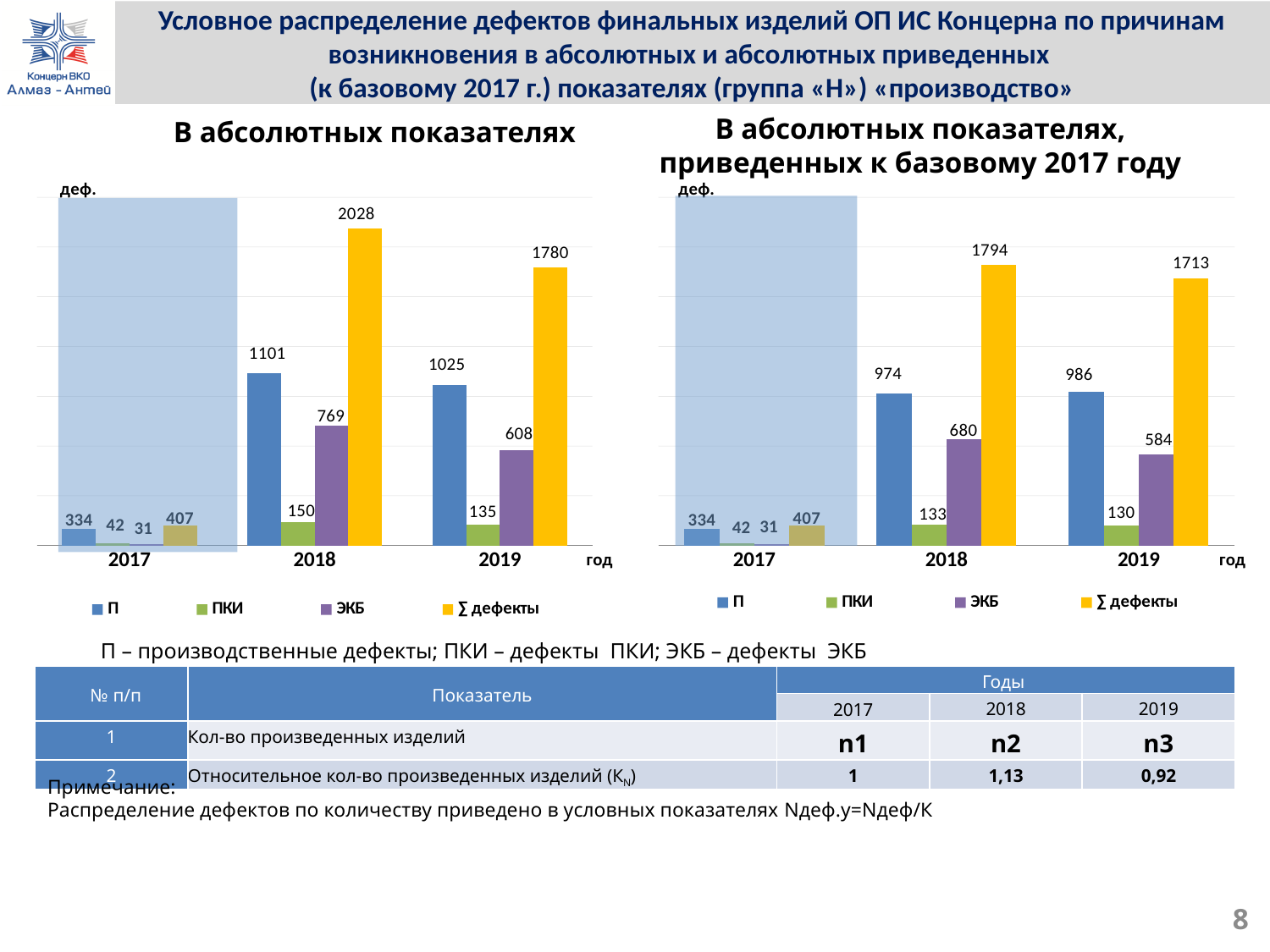
In the left chart 'В абсолютных показателях', which year has the lowest value of П? 2017 In the left chart 'В абсолютных показателях', what is the difference between ∑ дефекты in 2018 and in 2019? 248 How many series does the legend of the left chart 'В абсолютных показателях' list? 4 What type of chart is the left chart 'В абсолютных показателях'? Bar chart In the right chart 'В абсолютных показателях, приведенных к базовому 2017 году', what is the value of ∑ дефекты for 2019? 1713 In the right chart 'В абсолютных показателях, приведенных к базовому 2017 году', what is the value of П for 2018? 974 In the left chart 'В абсолютных показателях', which year has the highest value of ∑ дефекты? 2018 In the right chart 'В абсолютных показателях, приведенных к базовому 2017 году', which is larger: П in 2018 or П in 2019? П in 2019 In the left chart 'В абсолютных показателях', what is the value of ∑ дефекты for 2018? 2028 In the left chart 'В абсолютных показателях', what is the value of ЭКБ for 2019? 608 How many years are shown on the x axis of the right chart 'В абсолютных показателях, приведенных к базовому 2017 году'? 3 In the right chart 'В абсолютных показателях, приведенных к базовому 2017 году', what is the difference between ЭКБ in 2018 and in 2019? 96